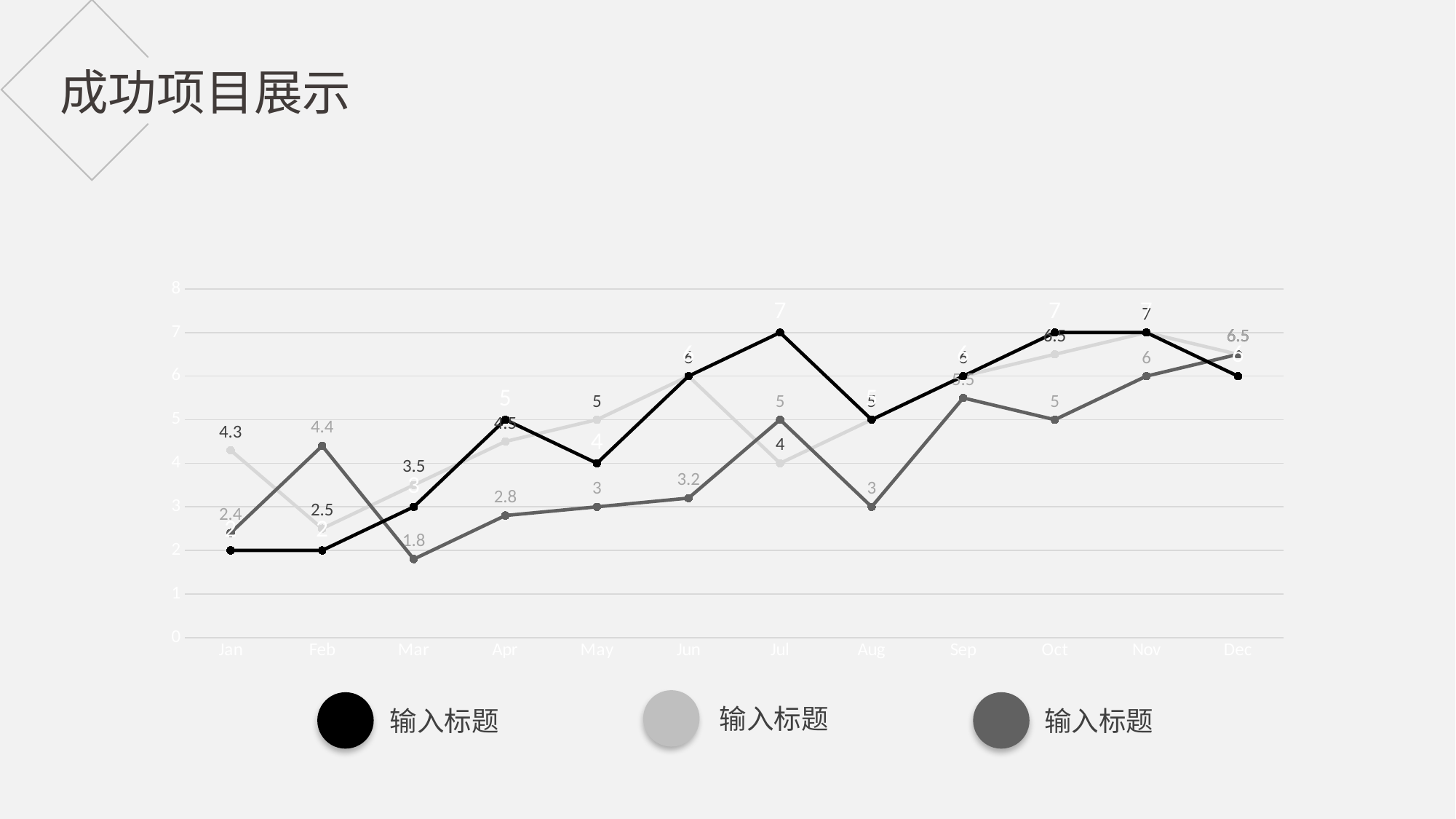
What is the difference between the black line and the dark grey line in July? 2 How many series does the legend list? 3 What kind of chart is shown on the slide? line chart What is the value of the light grey line in January? 4.3 Does the dark grey line generally rise or fall from August to December? rise What is the value of the dark grey line in February? 4.4 What is the value of the black line in July? 7 Which line has the higher value in February, the black line or the dark grey line? dark grey line In which month does the dark grey line reach its lowest value? Mar How many months are plotted along the x axis? 12 What is the value of the dark grey line in March? 1.8 Is the value of the dark grey line in April greater or less than 3? less